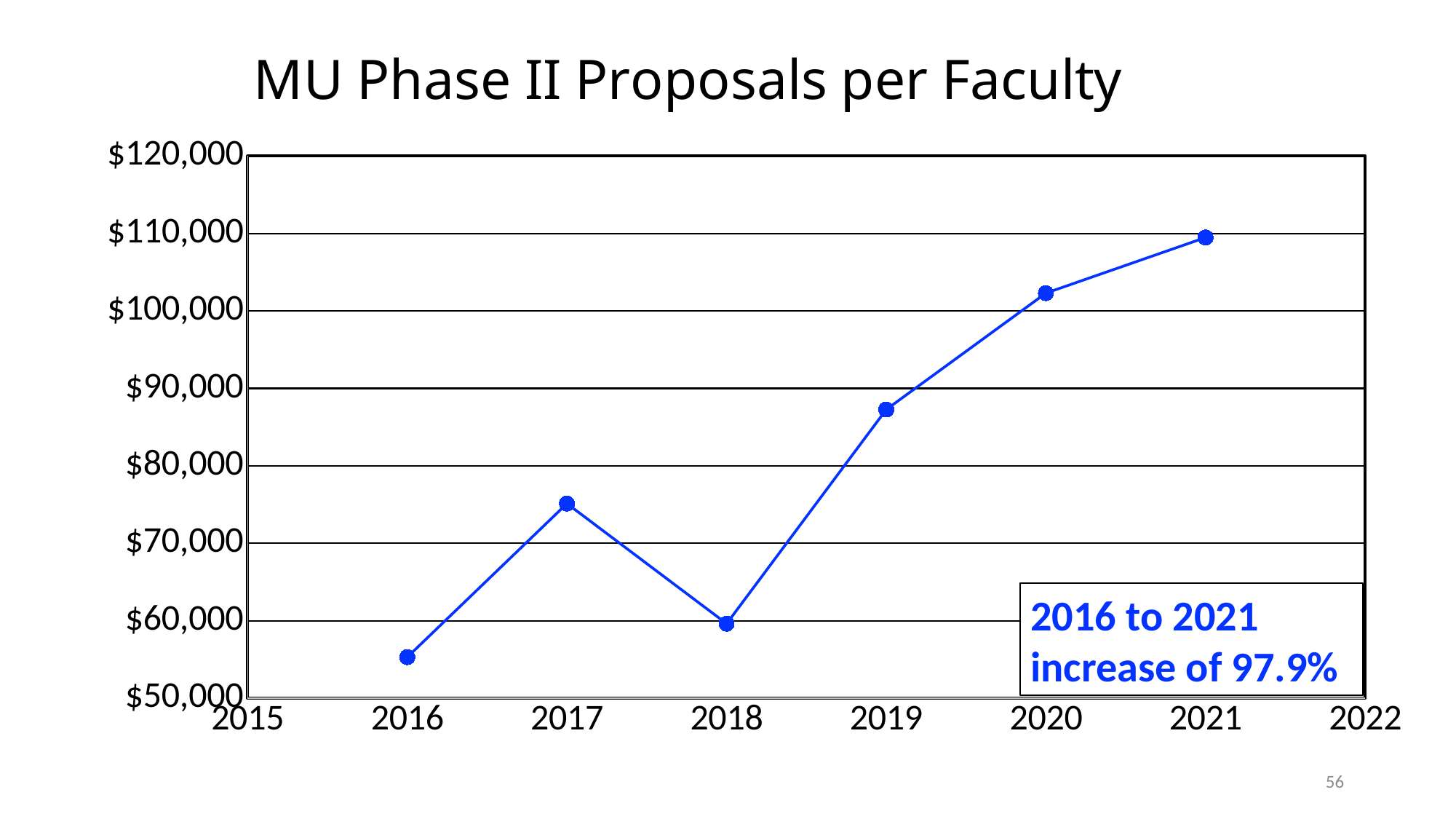
What is the title of the chart? MU Phase II Proposals per Faculty Is the value for 2021 greater or less than $100,000? greater Is the value for 2017 greater or less than $70,000? greater How many data points are plotted on the line? 6 Is the value for 2019 greater or less than $90,000? less Which year has the lowest value? 2016 Which year has the larger value, 2017 or 2018? 2017 Do the values rise or fall from 2018 to 2021? rise According to the text box on the chart, what is the percentage increase from 2016 to 2021? 97.9% Which year has the highest value? 2021 What type of chart is shown on the slide? line chart